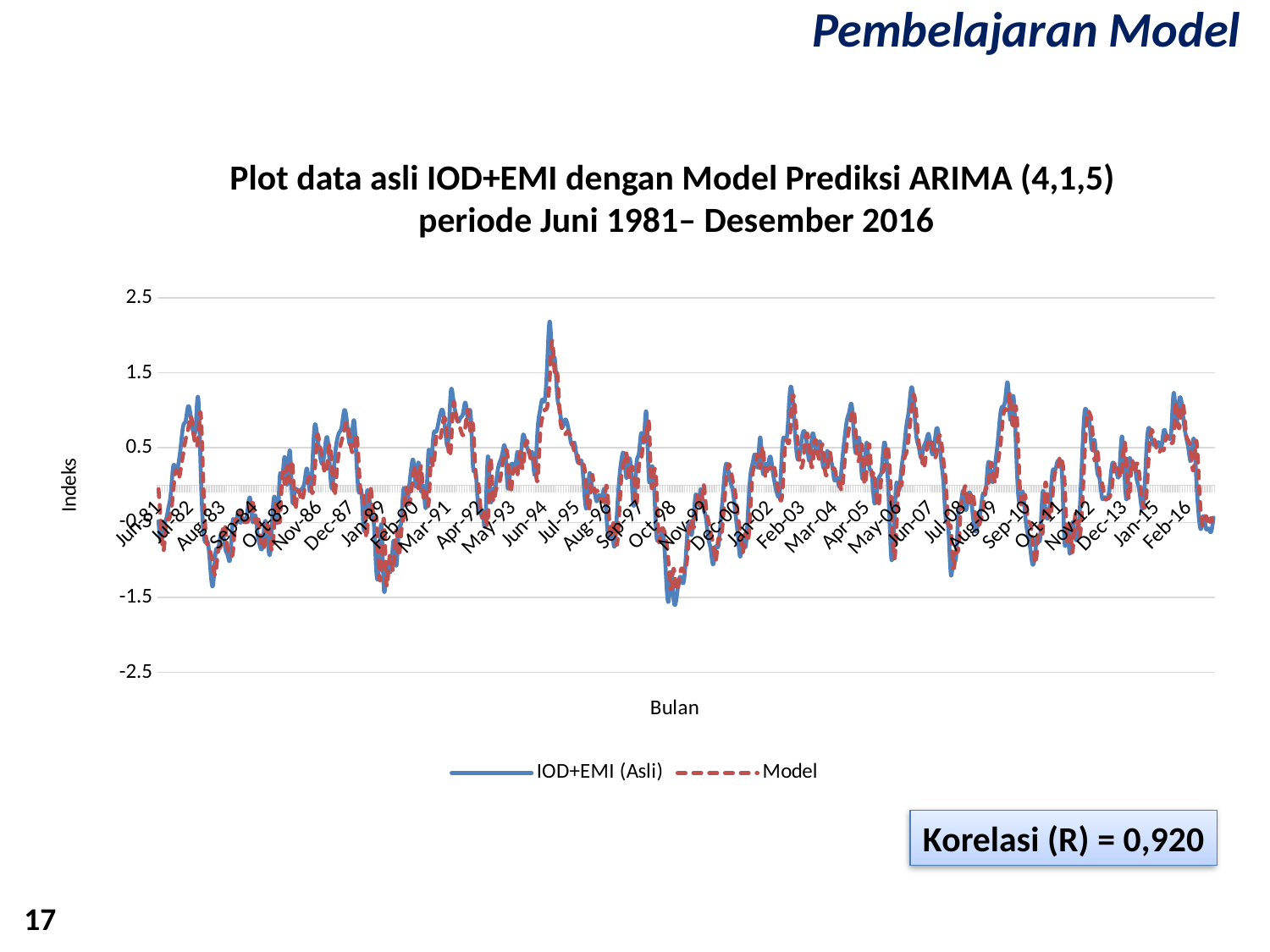
What kind of chart is shown on the slide? line chart Is the value of the Model series near Oct-98 greater or less than -0.5? less What is the label of the vertical axis of the chart? Indeks Around which x-axis label does the IOD+EMI (Asli) series reach its highest peak? Jun-94 What are the two series named in the chart legend? IOD+EMI (Asli) and Model What is the highest value shown on the vertical axis of the chart? 2.5 Which is larger: the peak of the IOD+EMI (Asli) series near Jun-94 or its peak near Jul-82? Jun-94 How many series does the chart legend list? 2 Is the peak value of the IOD+EMI (Asli) series near Jun-94 greater or less than 1.5? greater Is the value of the IOD+EMI (Asli) series near Jan-89 greater or less than -0.5? less